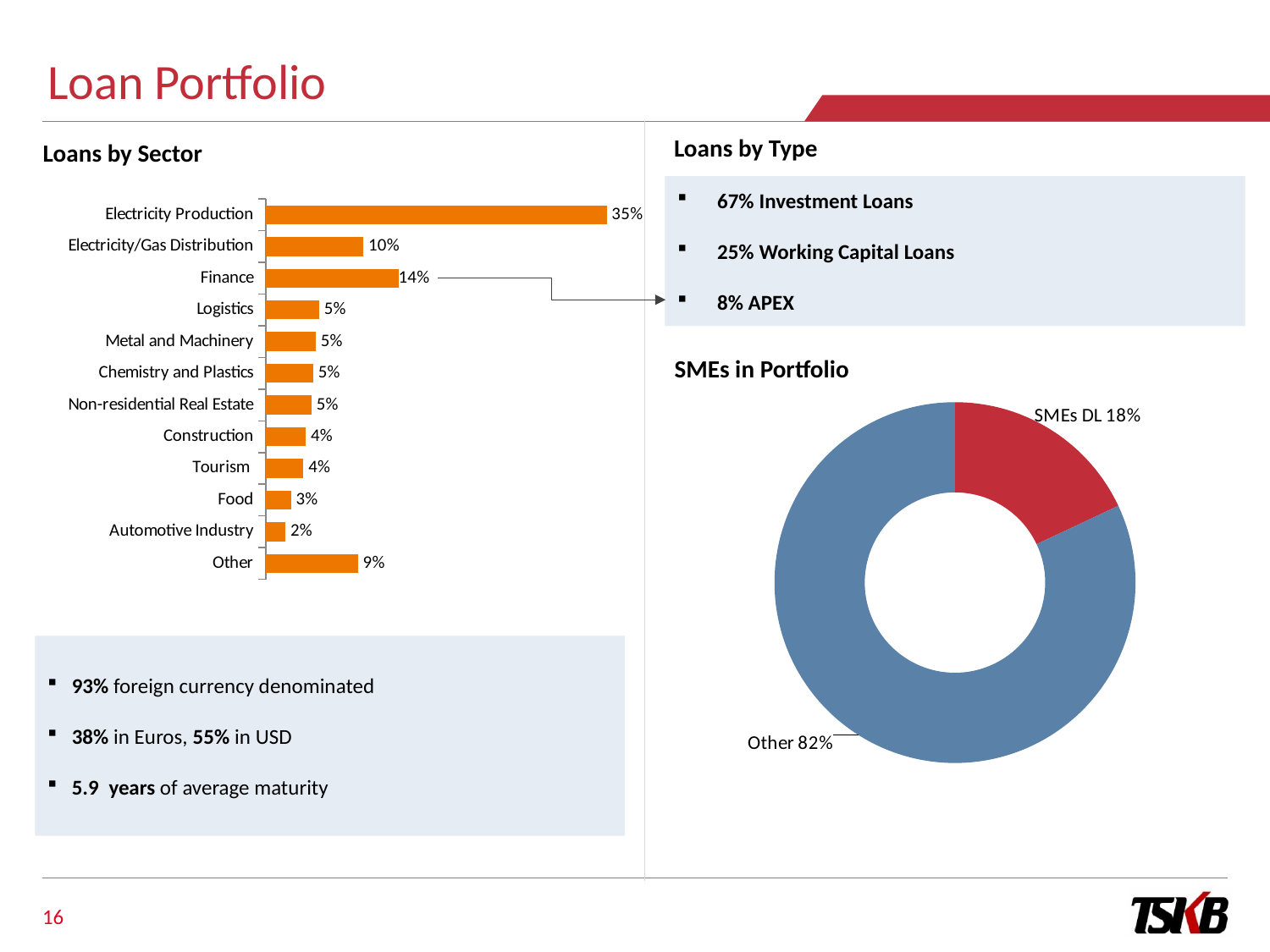
What kind of chart is the Loans by Sector chart? Bar chart In the Loans by Sector chart, what is the difference between Electricity Production and Electricity/Gas Distribution? 25% In the SMEs in Portfolio chart, what share is Other? 82% In the Loans by Sector chart, which is larger, Finance or Electricity/Gas Distribution? Finance How many sectors are shown in the Loans by Sector chart? 12 In the Loans by Sector chart, which sector has the highest share? Electricity Production In the Loans by Sector chart, which sector has the lowest share? Automotive Industry What kind of chart is the SMEs in Portfolio chart? Doughnut chart In the SMEs in Portfolio chart, what share is SMEs DL? 18% In the Loans by Sector chart, what is the value for Other? 9% In the Loans by Sector chart, what is the value for Finance? 14% In the Loans by Sector chart, what is the value for Electricity Production? 35%